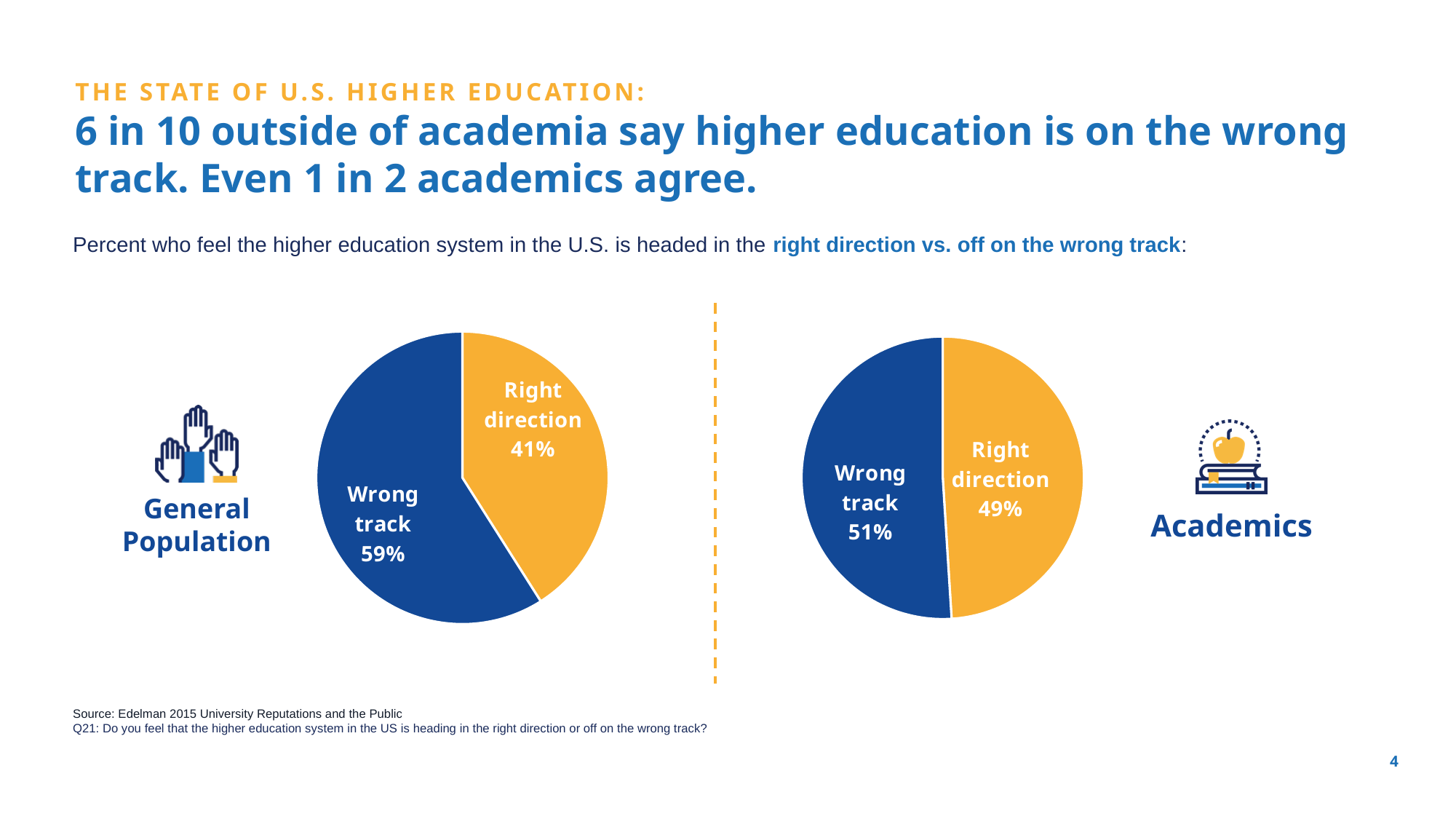
In the General Population pie chart, what percent say higher education is on the wrong track? 59% How many slices does the Academics pie chart have? 2 What colour is the Wrong track slice in both pie charts? Blue Which group has a higher Wrong track percentage: General Population or Academics? General Population In the Academics pie chart, what percent say higher education is on the wrong track? 51% In the General Population pie chart, what percent say higher education is headed in the right direction? 41% In the General Population pie chart, which slice is larger: Wrong track or Right direction? Wrong track In the General Population pie chart, what is the difference between the Wrong track and Right direction percentages? 18% In the Academics pie chart, what is the difference between the Wrong track and Right direction percentages? 2% What type of chart is used on the left for the General Population? Pie chart In the Academics pie chart, what percent say higher education is headed in the right direction? 49% In the General Population pie chart, what share of the pie does the Right direction slice represent? 41%